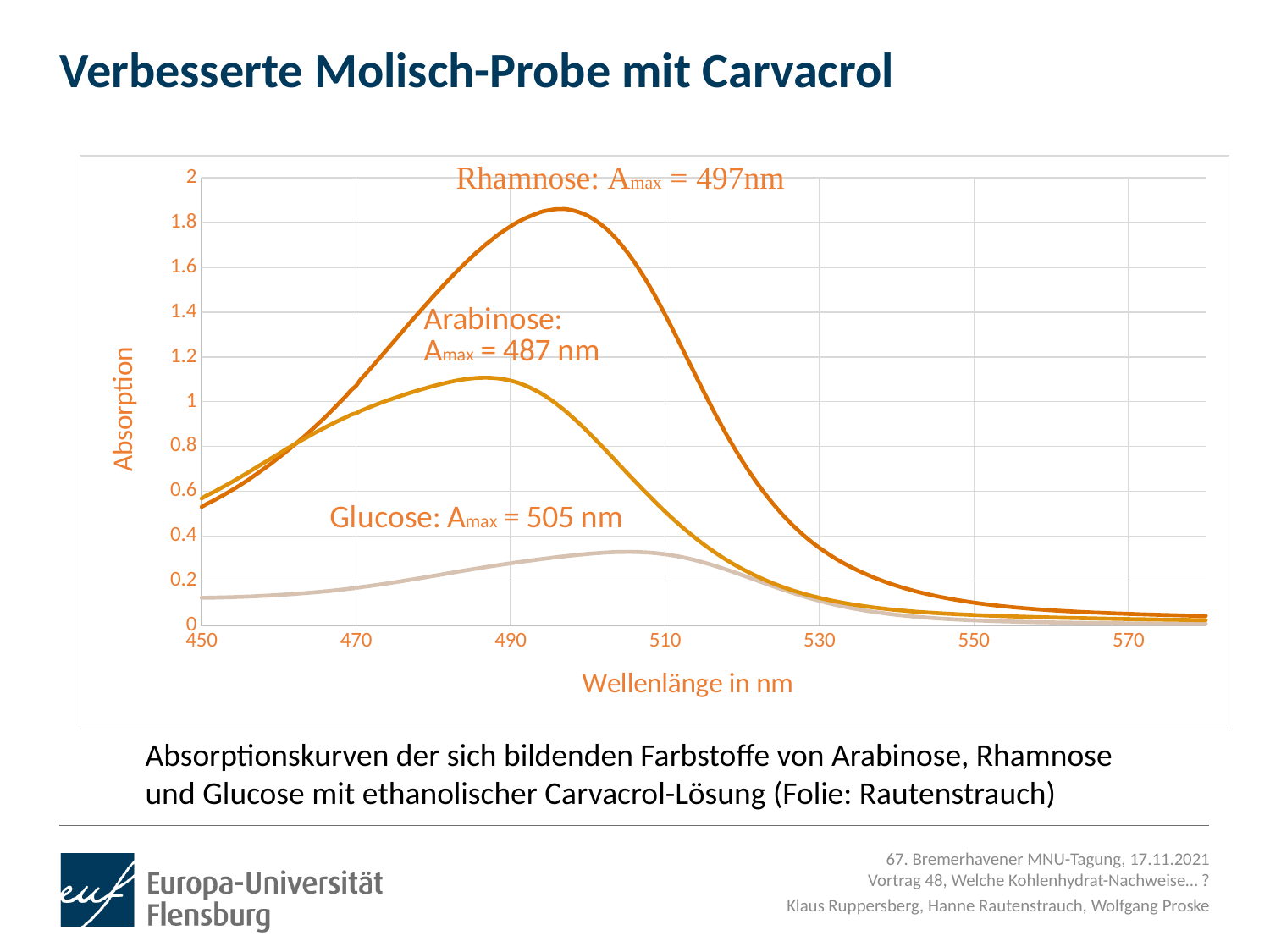
At what wavelength does Arabinose reach its absorption maximum (Amax) according to the chart annotation? 487 nm Which curve has a higher peak absorption, Arabinose or Glucose? Arabinose How many nanometres apart are the Amax wavelengths of Glucose (505 nm) and Arabinose (487 nm)? 18 nm At what wavelength does Glucose reach its absorption maximum (Amax) according to the chart annotation? 505 nm What kind of chart is shown on the slide? line chart How many absorption curves are plotted in the chart? 3 Is the peak absorption of Glucose greater or less than 0.4? less At what wavelength does Rhamnose reach its absorption maximum (Amax) according to the chart annotation? 497nm What is the label of the x axis of the chart? Wellenlänge in nm Which of the three sugars has the highest peak absorption in the chart? Rhamnose Which of the three sugars has the lowest peak absorption in the chart? Glucose Is the peak absorption of Rhamnose greater or less than 1.6? greater